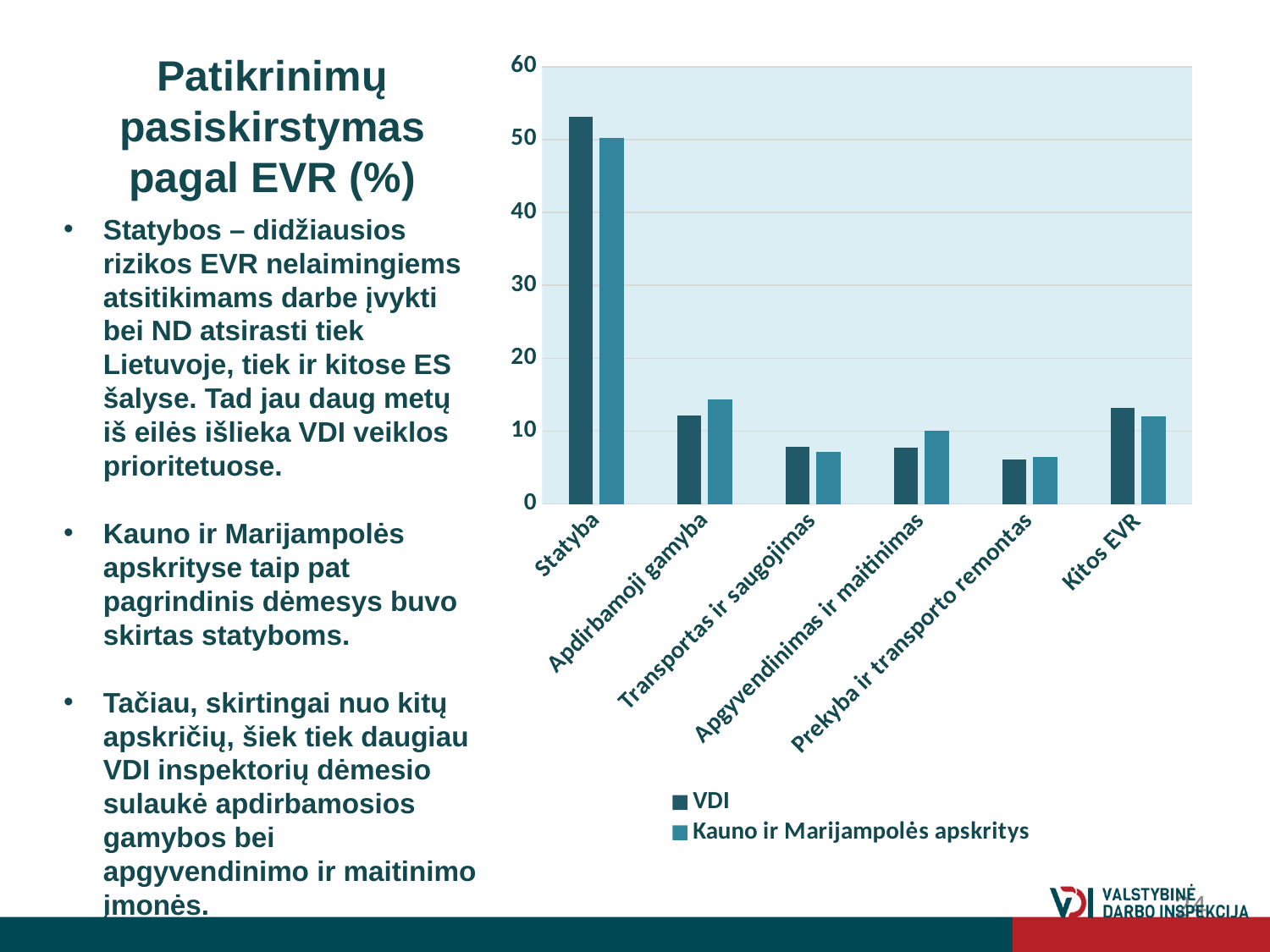
For Apdirbamoji gamyba, which series has the larger value, VDI or Kauno ir Marijampolės apskritys? Kauno ir Marijampolės apskritys Is the VDI value for Prekyba ir transporto remontas greater or less than 10? less For Statyba, which series has the larger value, VDI or Kauno ir Marijampolės apskritys? VDI What are the two series named in the chart's legend? VDI; Kauno ir Marijampolės apskritys Which category has the lowest value for the VDI series? Prekyba ir transporto remontas Is the VDI value for Statyba greater or less than 50? greater Which category has the highest value for the VDI series? Statyba What kind of chart is shown on the slide? bar chart How many categories are shown on the x axis of the chart? 6 How many series does the chart's legend list? 2 Which category has the highest value for the Kauno ir Marijampolės apskritys series? Statyba Is the Kauno ir Marijampolės apskritys value for Apdirbamoji gamyba greater or less than 10? greater